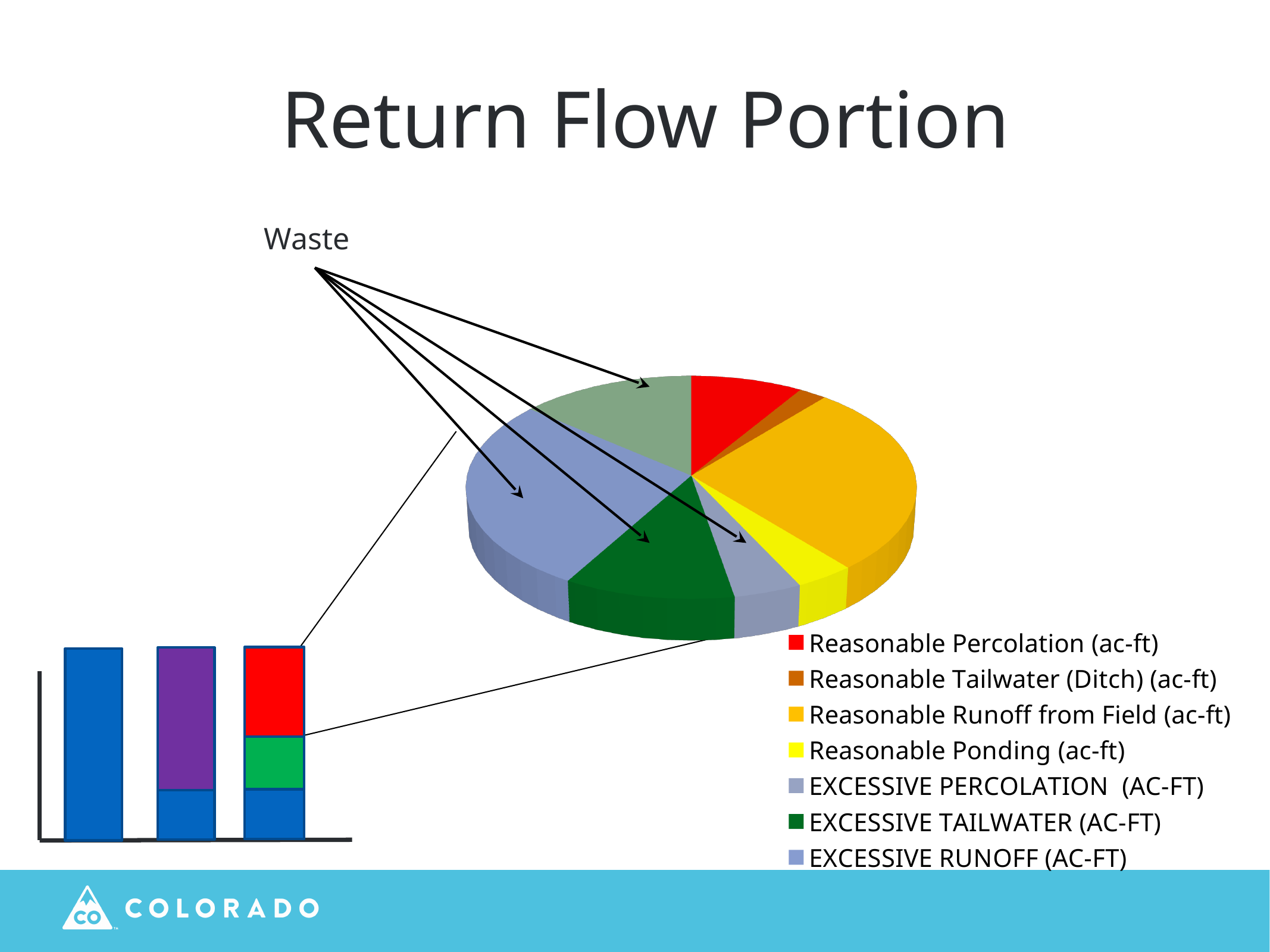
In the pie chart, which slice is larger: EXCESSIVE RUNOFF (AC-FT) or EXCESSIVE PERCOLATION (AC-FT)? EXCESSIVE RUNOFF (AC-FT) In the pie chart, which slice is larger: EXCESSIVE TAILWATER (AC-FT) or Reasonable Ponding (ac-ft)? EXCESSIVE TAILWATER (AC-FT) What is the title of the slide containing the pie chart? Return Flow Portion What colour represents Reasonable Ponding (ac-ft) in the pie chart legend? yellow In the pie chart, which slice is larger: Reasonable Percolation (ac-ft) or Reasonable Tailwater (Ditch) (ac-ft)? Reasonable Percolation (ac-ft) What kind of chart is shown on the slide under the title "Return Flow Portion"? pie chart Which category has the smallest slice in the pie chart? Reasonable Tailwater (Ditch) (ac-ft) How many entries does the legend of the pie chart list? 7